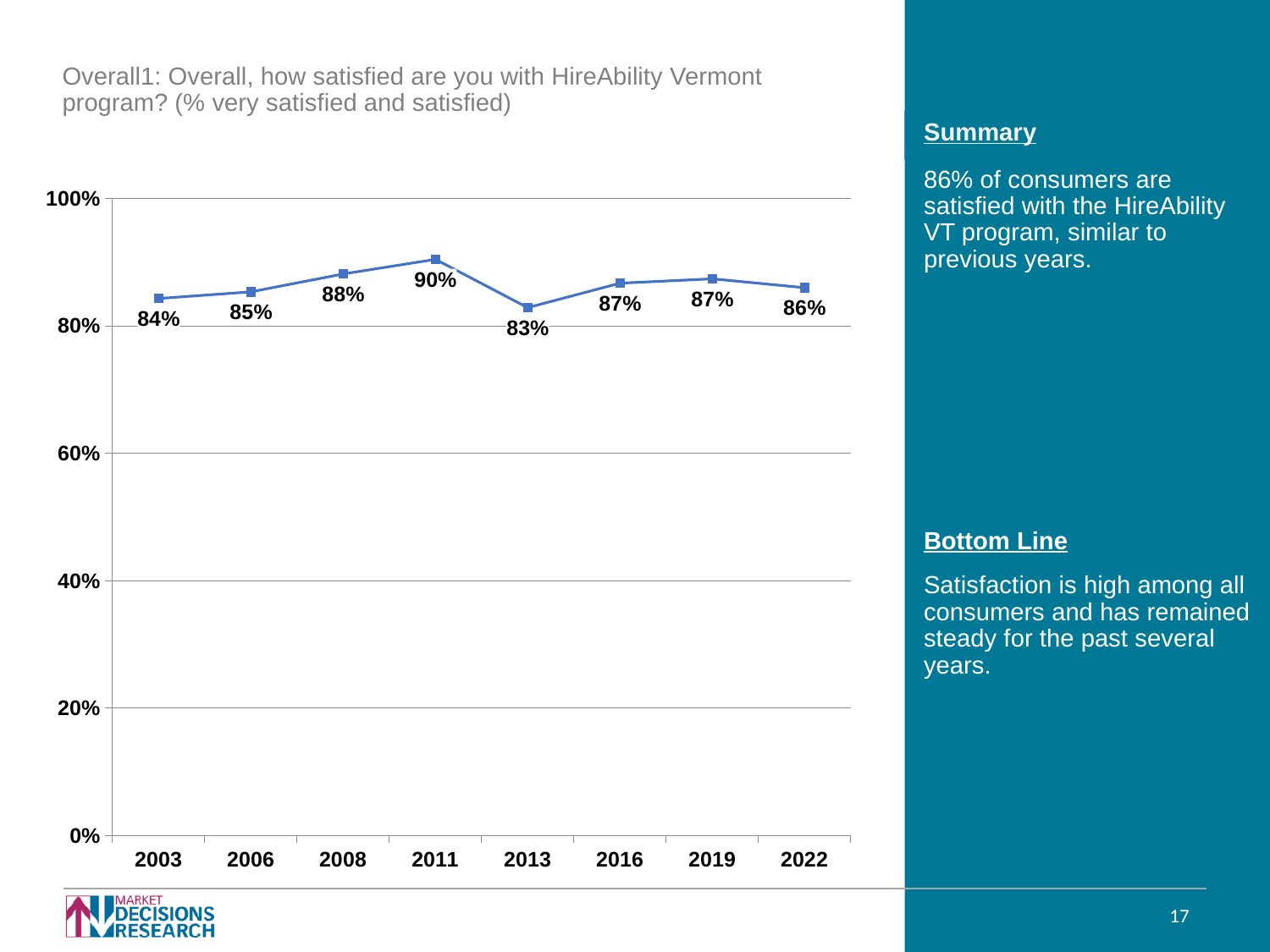
What is the difference between the 2011 value and the 2013 value? 7% What is the satisfaction value for 2003? 84% Do the values rise or fall from 2003 to 2011? rise Which year has the highest satisfaction value? 2011 What is the difference between the 2016 value and the 2003 value? 3% Which is larger, the value for 2008 or the value for 2022? 2008 Which year has the lowest satisfaction value? 2013 Is the value for 2019 greater or less than 80%? greater How many years are plotted on the chart? 8 What is the satisfaction value for 2013? 83% What kind of chart is shown on the slide? line chart What is the satisfaction value for 2022? 86%